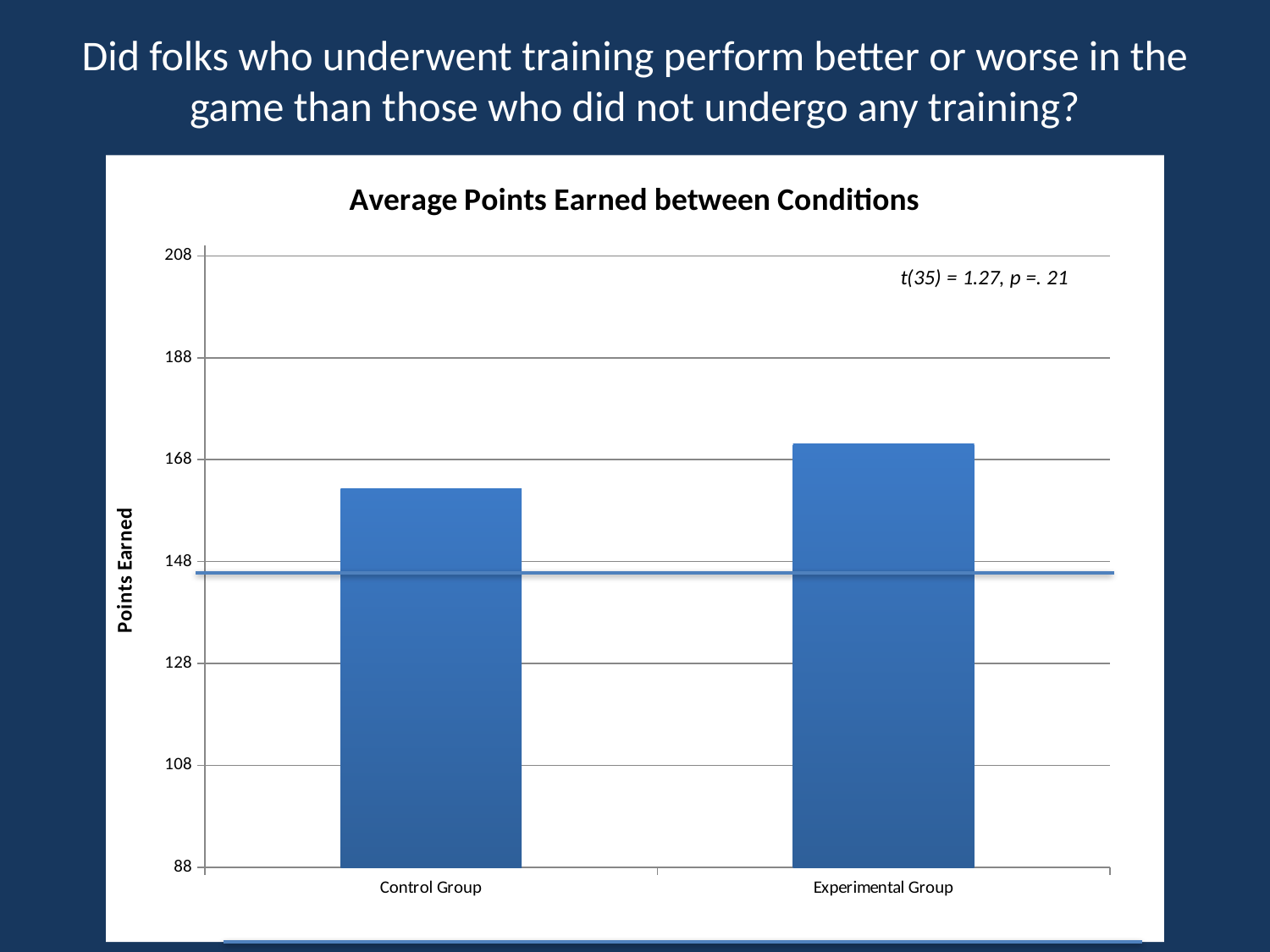
What is the label on the vertical axis of the chart? Points Earned Is the value for the Control Group greater or less than 168? less What kind of chart is shown on the slide? bar chart How many categories are plotted on the x axis of the chart? 2 Is the value for the Experimental Group greater or less than 168? greater Which group has the lower average points earned? Control Group Is the value for the Control Group greater or less than 148? greater Is the value for the Control Group larger or smaller than the value for the Experimental Group? smaller Do the bar values rise or fall from the Control Group to the Experimental Group? rise What is the title of the chart? Average Points Earned between Conditions Which group has the higher average points earned? Experimental Group